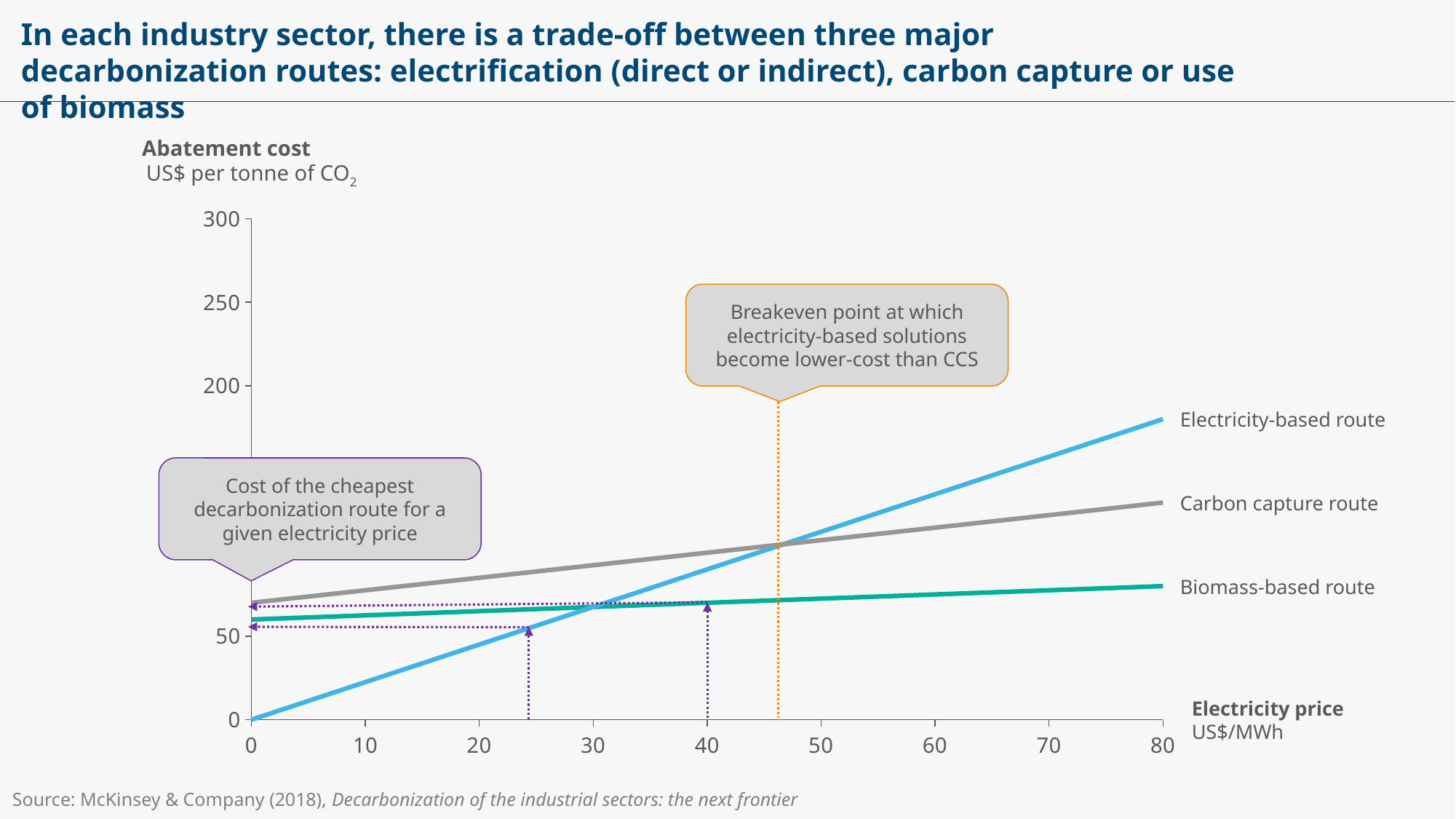
Is the abatement cost of the Electricity-based route at an electricity price of 80 US$/MWh greater or less than 150? greater What unit is used for the vertical axis (abatement cost)? US$ per tonne of CO2 Is the abatement cost of the Biomass-based route at an electricity price of 80 US$/MWh greater or less than 100? less Which route has the lowest abatement cost at an electricity price of 0 US$/MWh? Electricity-based route At an electricity price of 80 US$/MWh, which has the higher abatement cost: the Carbon capture route or the Biomass-based route? Carbon capture route What is the abatement cost of the Electricity-based route at an electricity price of 0 US$/MWh? 0 What kind of chart is shown on the slide? Line chart Does the abatement cost of the Electricity-based route rise or fall as the electricity price increases? Rises How many routes (lines) are plotted on the chart? 3 Which route has the highest abatement cost at an electricity price of 80 US$/MWh? Electricity-based route Is the abatement cost of the Carbon capture route at an electricity price of 80 US$/MWh greater or less than 150? less